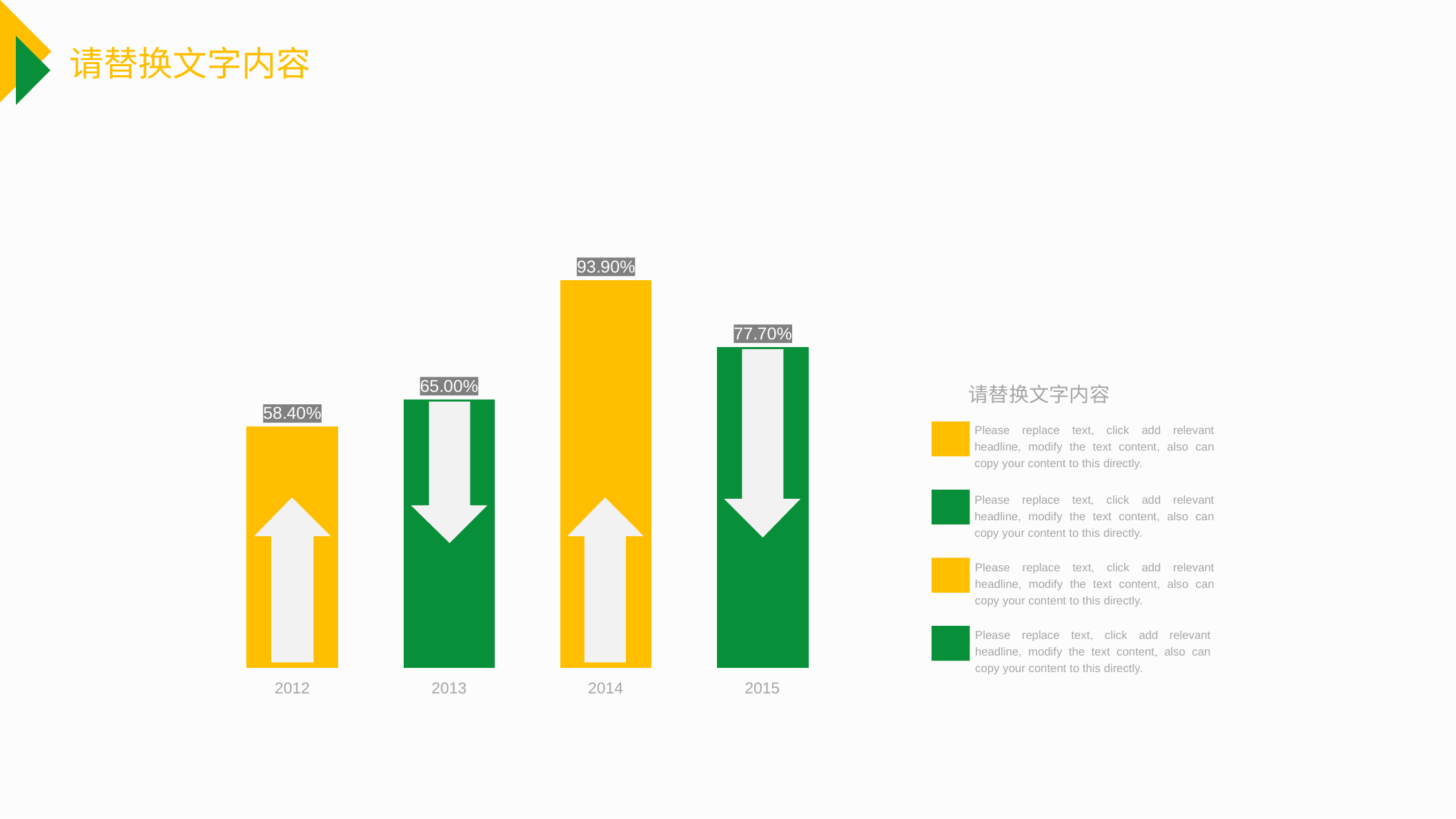
What is the value shown for 2012? 58.40% What colour is the bar for 2014? yellow Which is larger, the value for 2013 or the value for 2015? 2015 What is the value shown for 2013? 65.00% Which year has the lowest value? 2012 What is the difference between the values for 2013 and 2012? 6.60% How many years are shown on the x axis of the chart? 4 Which year has the highest value? 2014 What is the value shown for 2014? 93.90% What kind of chart is shown on the slide? bar chart What is the difference between the values for 2014 and 2015? 16.20% What is the value shown for 2015? 77.70%